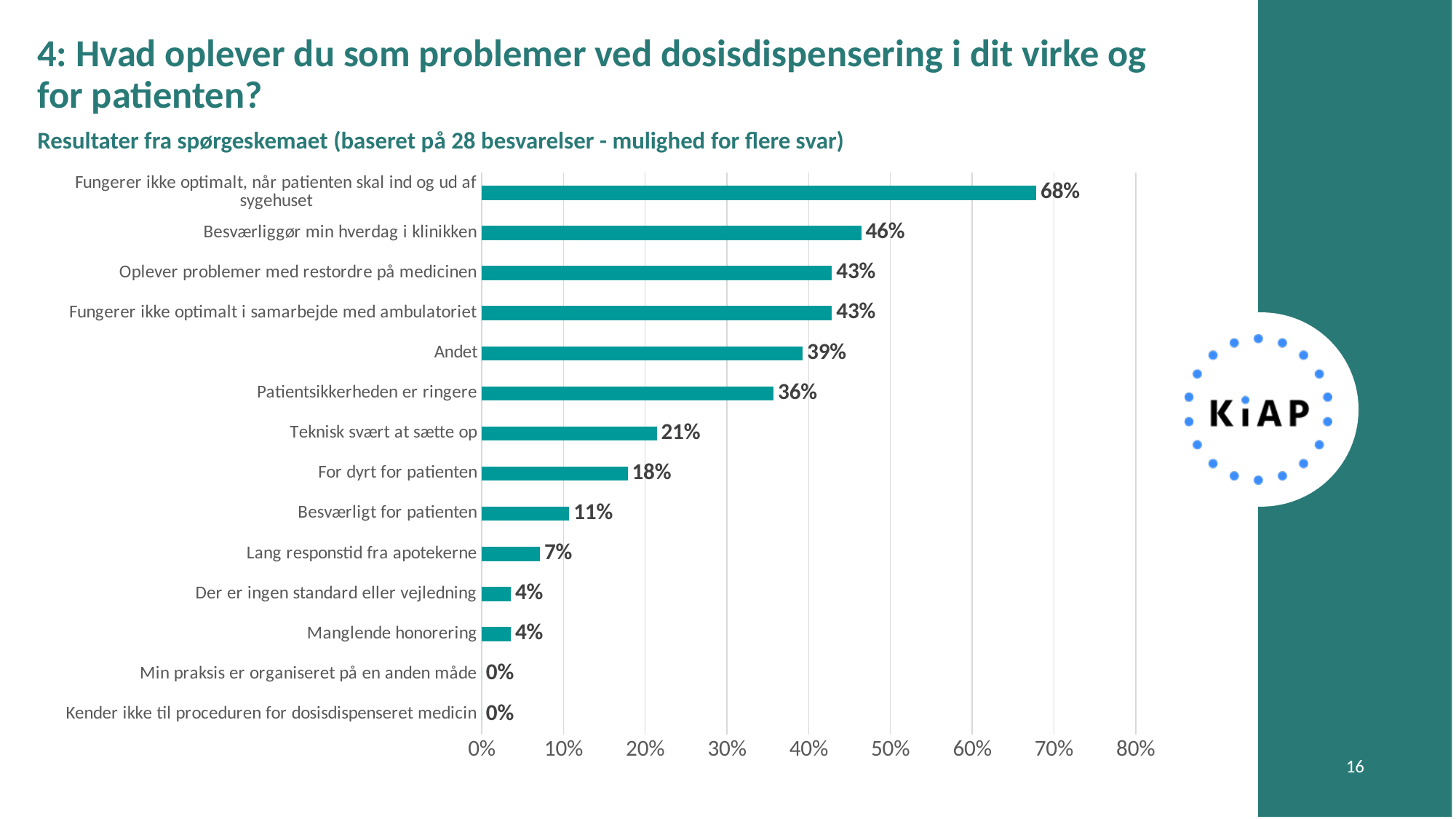
What is the difference between the values for "Fungerer ikke optimalt, når patienten skal ind og ud af sygehuset" and "Besværliggør min hverdag i klinikken"? 22% What is the value for "Patientsikkerheden er ringere"? 36% Which is larger, the value for "Teknisk svært at sætte op" or the value for "For dyrt for patienten"? Teknisk svært at sætte op How many responses is the chart based on, according to the subtitle? 28 What is the difference between the values for "Besværligt for patienten" and "Der er ingen standard eller vejledning"? 7% What kind of chart is shown on the slide? Bar chart How many categories are shown in the chart? 14 What is the value for "Besværliggør min hverdag i klinikken"? 46% What is the value for "Lang responstid fra apotekerne"? 7% Which category has the highest value? Fungerer ikke optimalt, når patienten skal ind og ud af sygehuset What is the value for "Andet"? 39% How many categories have a value of 0%? 2